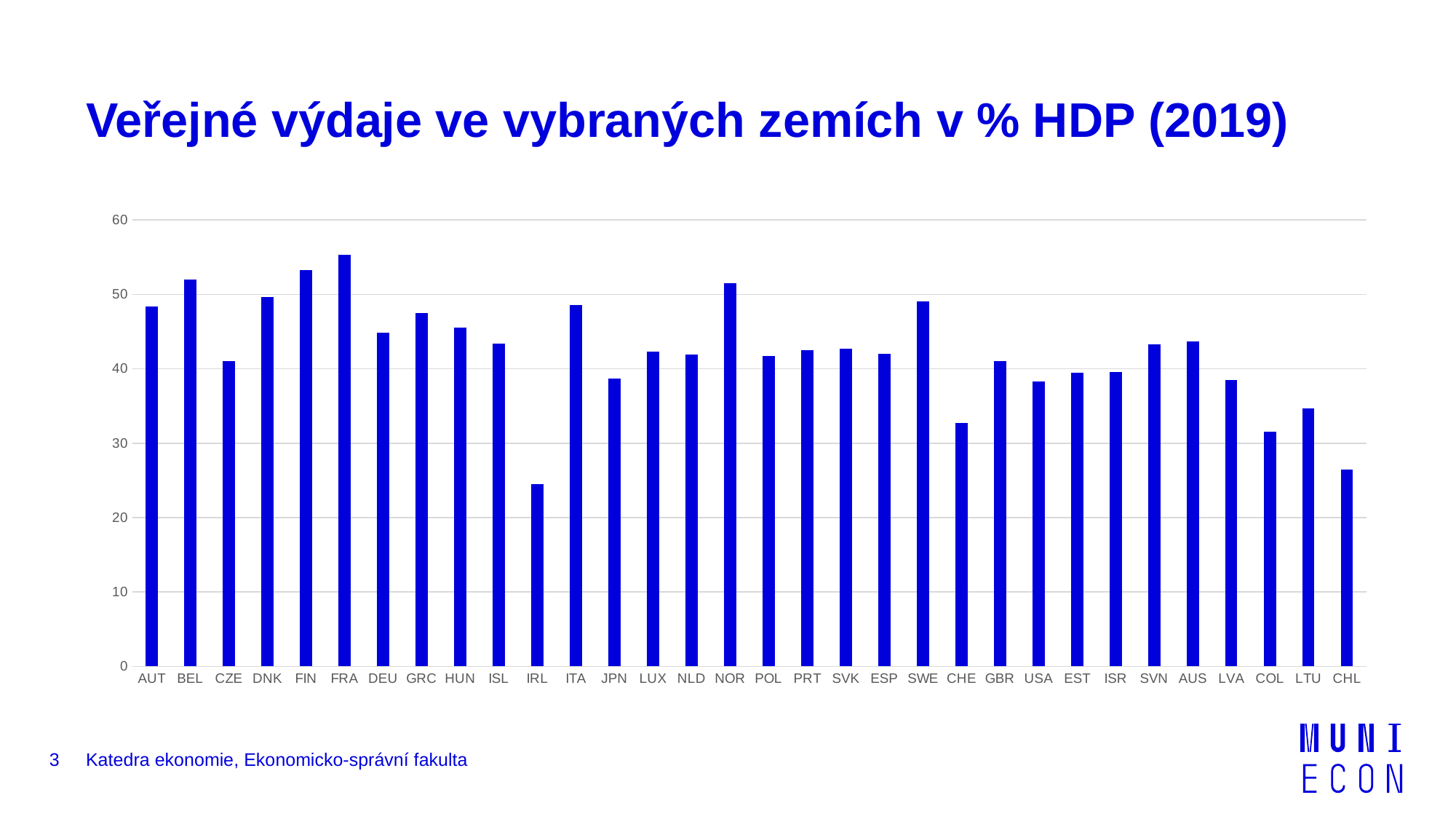
Which country has the highest value in the chart? FRA Which has the larger value, SWE or CHE? SWE Which has the larger value, BEL or AUT? BEL What is the title of the chart? Veřejné výdaje ve vybraných zemích v % HDP (2019) Which country has the lowest value in the chart? IRL Is the value for IRL greater or less than 30? less Is the value for COL greater or less than 40? less How many countries are shown on the x axis of the chart? 32 Is the value for FRA greater or less than 50? greater What kind of chart is shown on the slide? bar chart